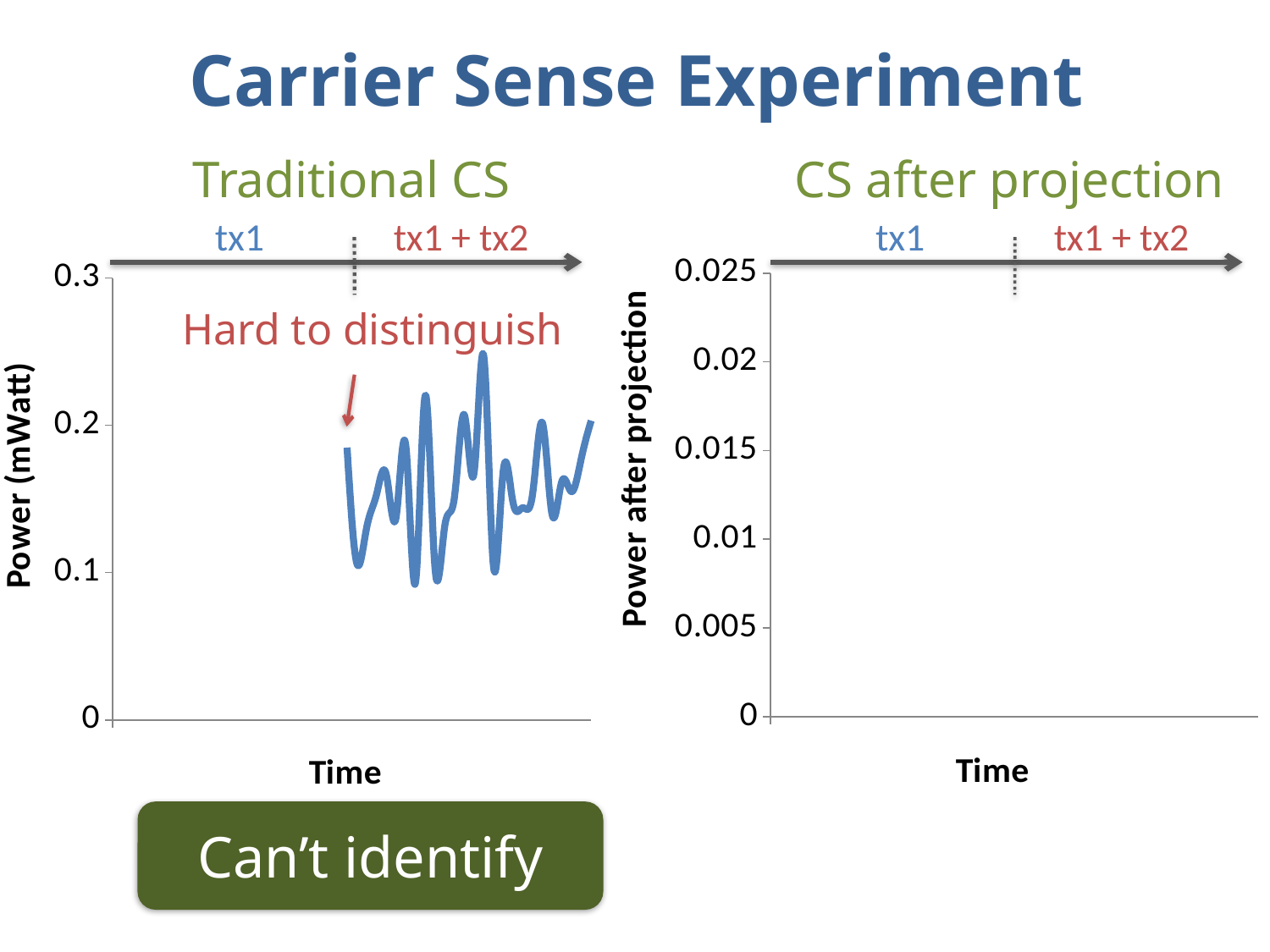
On the Traditional CS chart, is the highest point of the plotted line greater or less than 0.2? greater On the CS after projection chart, how many tick values are labelled on the y axis? 6 On the Traditional CS chart, what is the highest value shown on the y axis? 0.3 On the Traditional CS chart, how many tick values are labelled on the y axis? 4 On the Traditional CS chart, is the lowest point of the plotted line greater or less than 0.15? less On the CS after projection chart, what is the label of the y axis? Power after projection On the Traditional CS chart, what is the label of the y axis? Power (mWatt) On the Traditional CS chart, is the highest point of the plotted line greater or less than 0.3? less On the Traditional CS chart, what kind of chart is used to plot the data? line chart On the CS after projection chart, what is the highest value shown on the y axis? 0.025